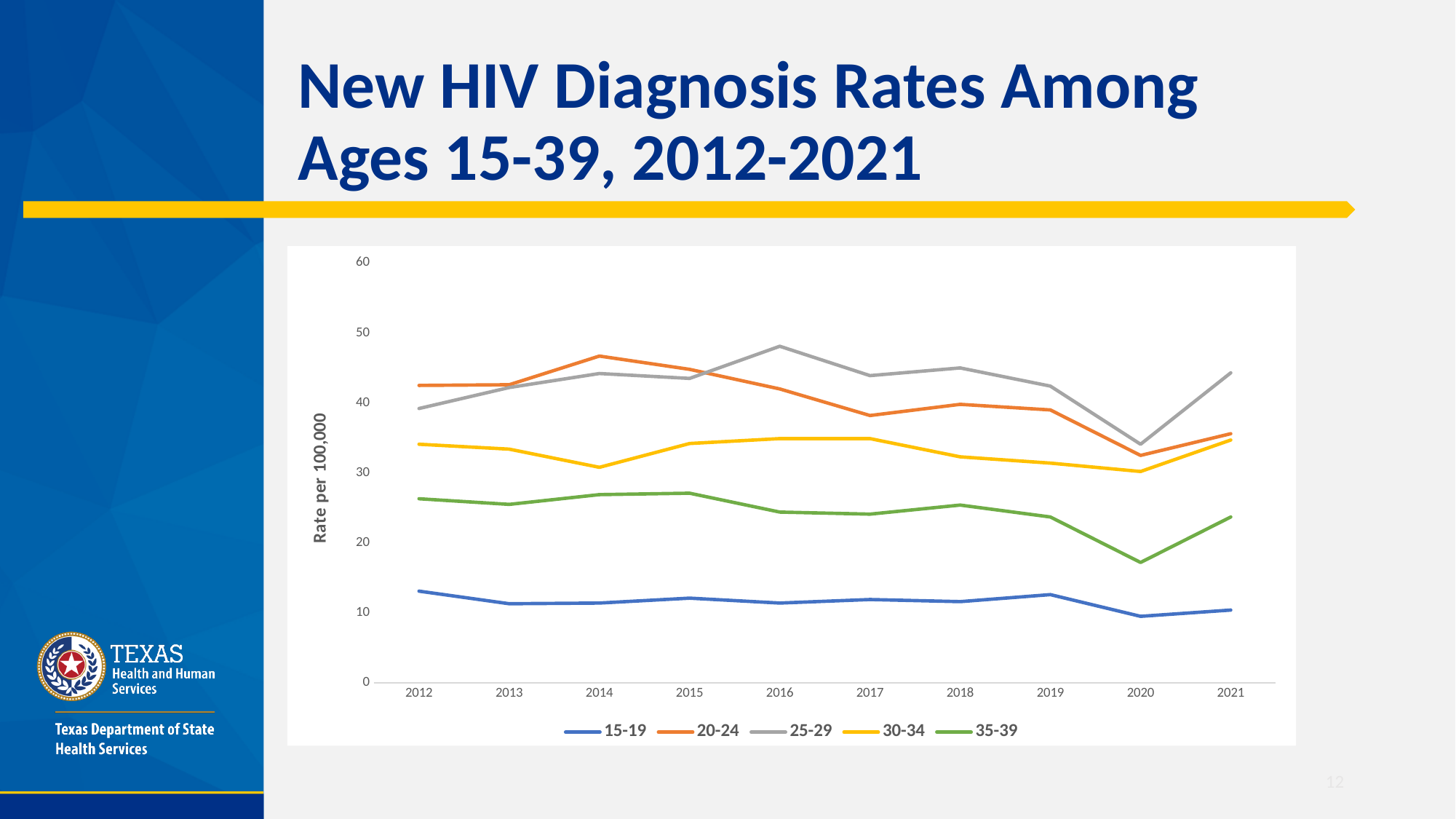
Which age groups are listed in the legend? 15-19, 20-24, 25-29, 30-34, 35-39 Is the value for the 25-29 age group in 2016 greater or less than 40? greater What kind of chart is shown on the slide? line chart How many series does the legend list? 5 Which age group has the highest rate in 2021? 25-29 Is the value for the 20-24 age group in 2017 greater or less than 30? greater Which age group has the lowest rate in every year shown? 15-19 Is the value for the 35-39 age group in 2020 greater or less than 20? less In 2014, which has the higher rate: the 20-24 age group or the 25-29 age group? 20-24 What is the label on the y axis? Rate per 100,000 How many years are plotted along the x axis? 10